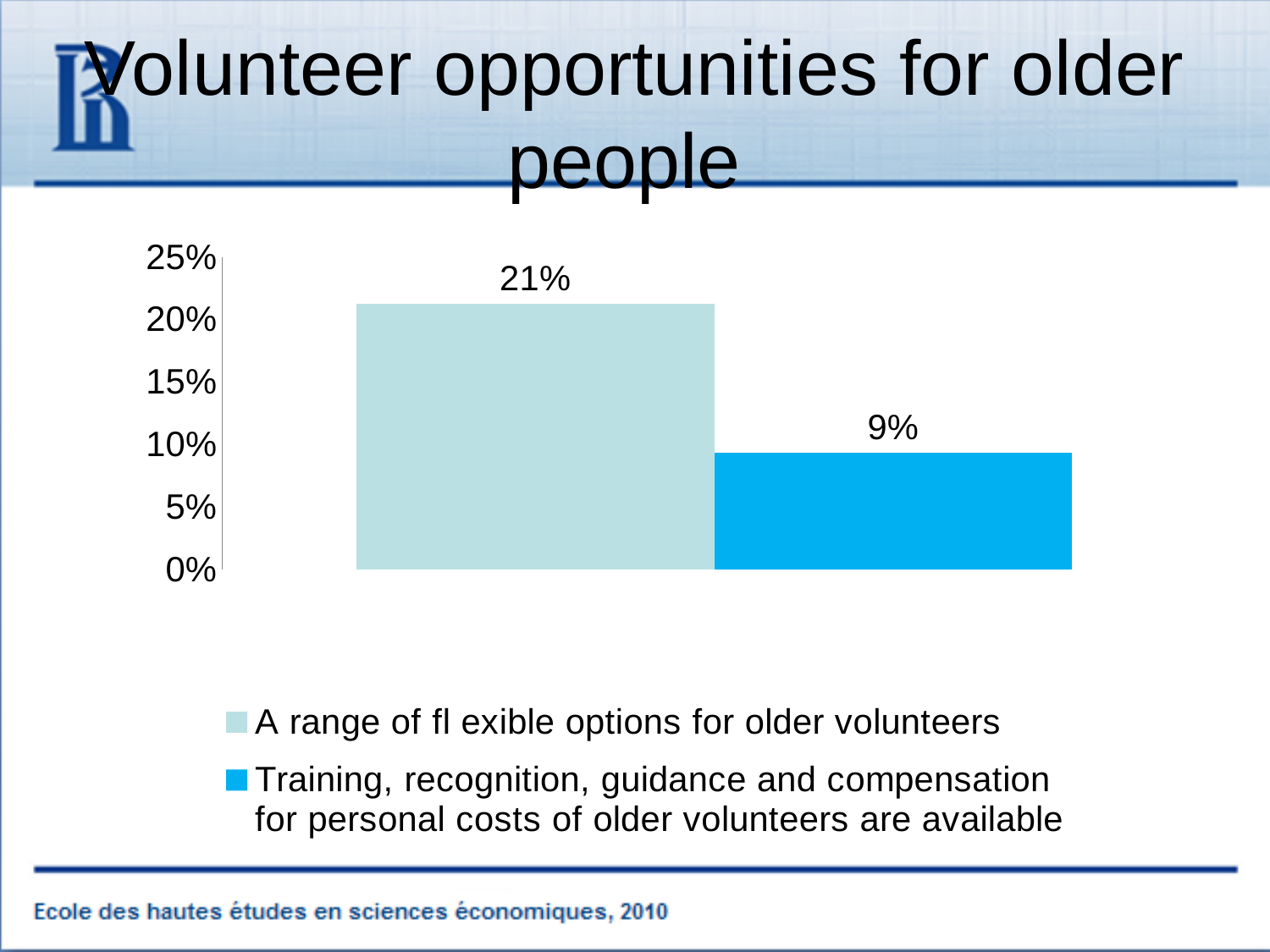
What kind of chart is shown on the slide? bar chart Is the value for 'A range of flexible options for older volunteers' greater or less than 20%? greater Which is larger: the value for 'A range of flexible options for older volunteers' or the value for 'Training, recognition, guidance and compensation for personal costs of older volunteers are available'? A range of flexible options for older volunteers What is the value for 'Training, recognition, guidance and compensation for personal costs of older volunteers are available'? 9% What is the value for 'A range of flexible options for older volunteers'? 21% What is the maximum value shown on the vertical axis? 25% Which series has the lowest value? Training, recognition, guidance and compensation for personal costs of older volunteers are available How many bars are plotted in the chart? 2 Which series has the highest value? A range of flexible options for older volunteers Is the value for 'Training, recognition, guidance and compensation for personal costs of older volunteers are available' greater or less than 10%? less What is the difference between the value for 'A range of flexible options for older volunteers' and the value for 'Training, recognition, guidance and compensation for personal costs of older volunteers are available'? 12% How many series does the legend list? 2